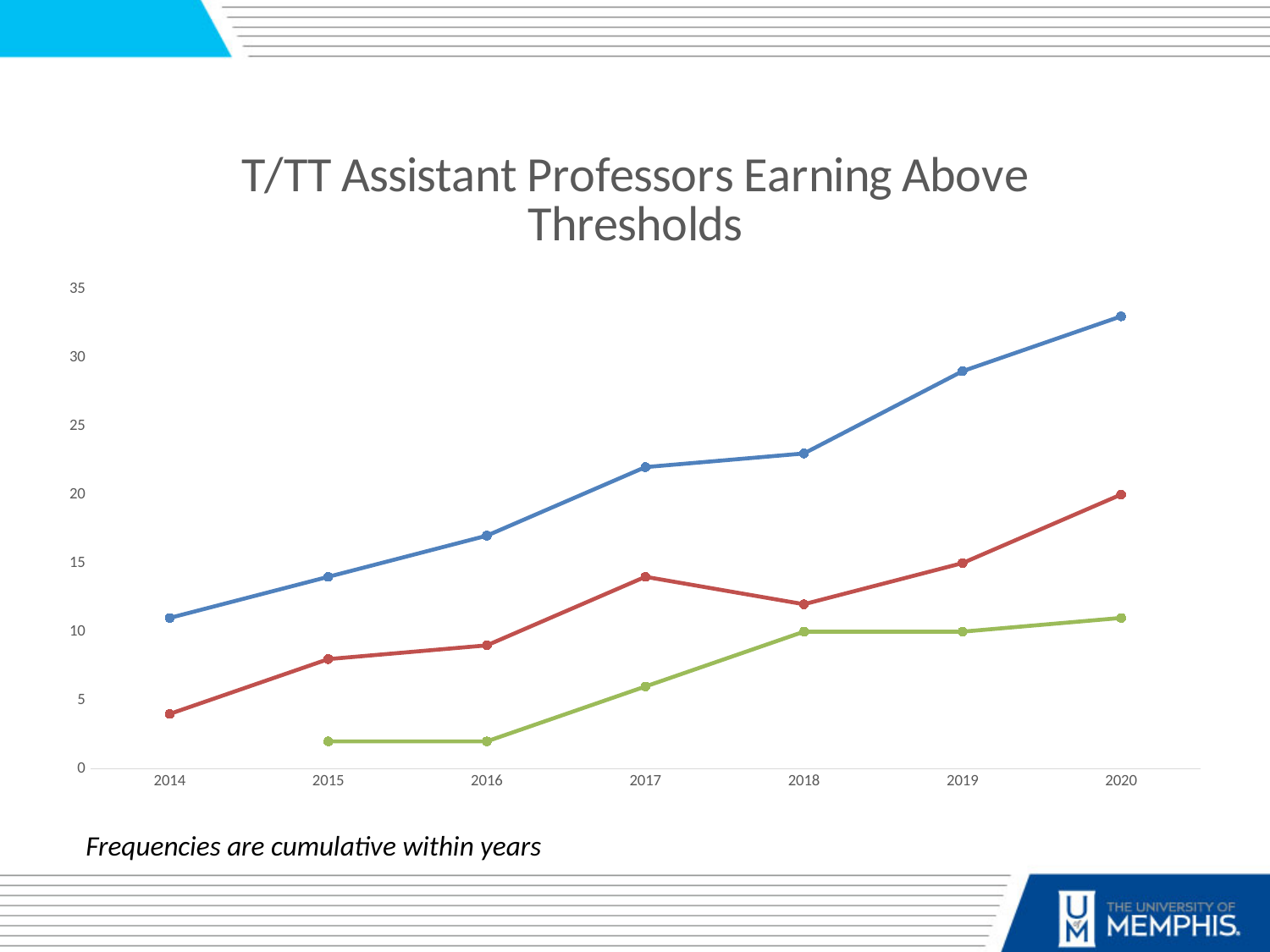
Does the blue line rise or fall from 2014 to 2020? rise What is the value of the red line in 2020? 20 In which year does the blue line reach its highest value? 2020 How many years are shown along the x axis? 7 Is the value of the blue line in 2014 greater or less than 15? less Is the value of the green line in 2016 greater or less than 5? less What kind of chart is shown on the slide? line chart What is the value of the green line in 2018? 10 What is the value of the red line in 2019? 15 Is the value of the blue line in 2020 greater or less than 30? greater How many lines are plotted on the chart? 3 What is the title of the chart? T/TT Assistant Professors Earning Above Thresholds